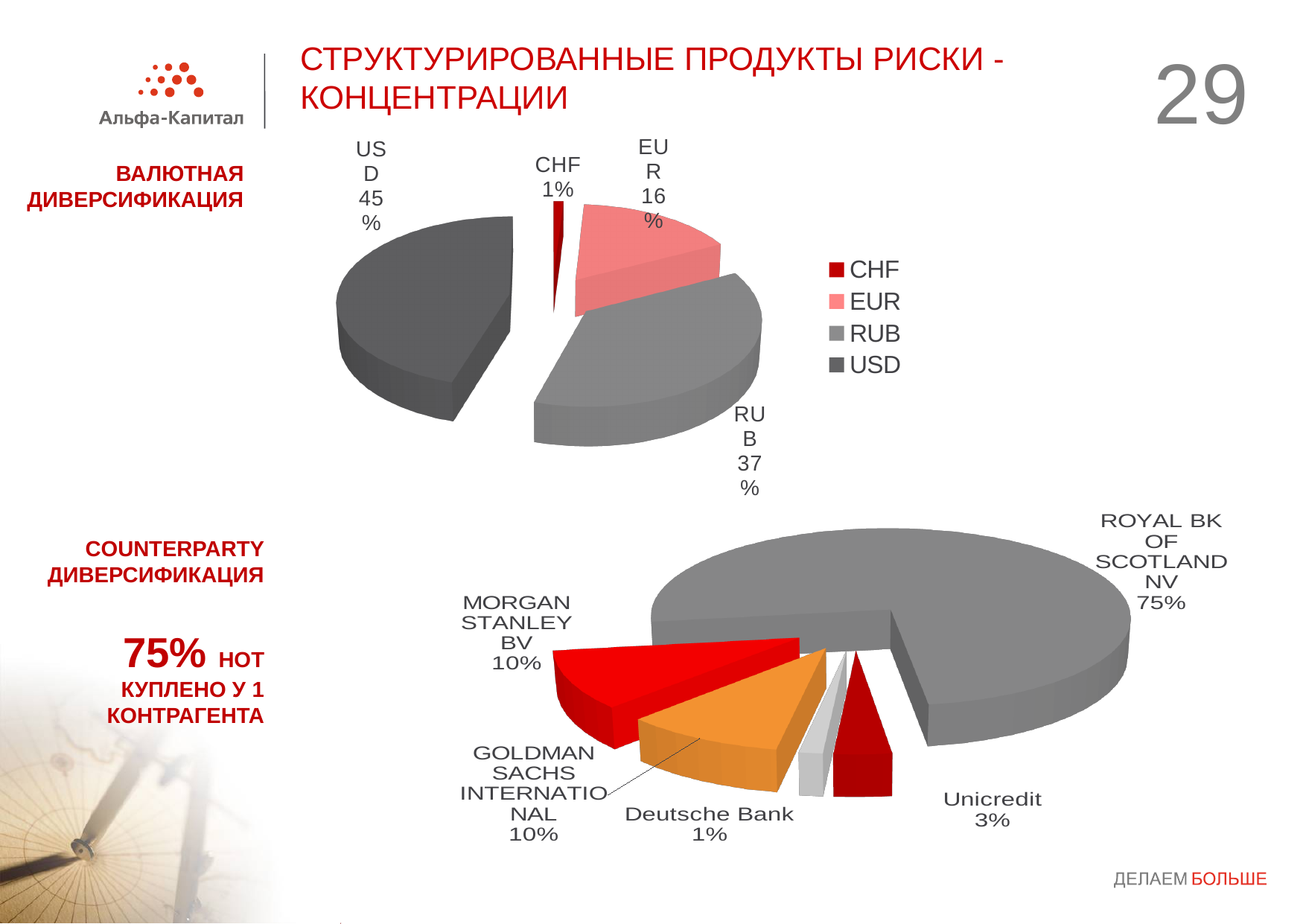
In the top pie chart (currency diversification), what share does RUB have? 37% In the bottom pie chart (counterparty diversification), what share does Unicredit have? 3% In the top pie chart (currency diversification), what share does USD have? 45% In the top pie chart (currency diversification), what is the difference between the USD and EUR shares? 29% In the bottom pie chart (counterparty diversification), what share does ROYAL BK OF SCOTLAND NV have? 75% In the bottom pie chart (counterparty diversification), which is larger: the share of Unicredit or the share of Deutsche Bank? Unicredit In the bottom pie chart (counterparty diversification), which counterparty has the smallest share? Deutsche Bank How many entries does the legend of the top pie chart list? 4 In the top pie chart (currency diversification), which currency has the largest share? USD What type of chart is used for the counterparty diversification at the bottom of the slide? Pie chart How many counterparties are shown in the bottom pie chart? 5 In the top pie chart (currency diversification), which currency has the smallest share? CHF